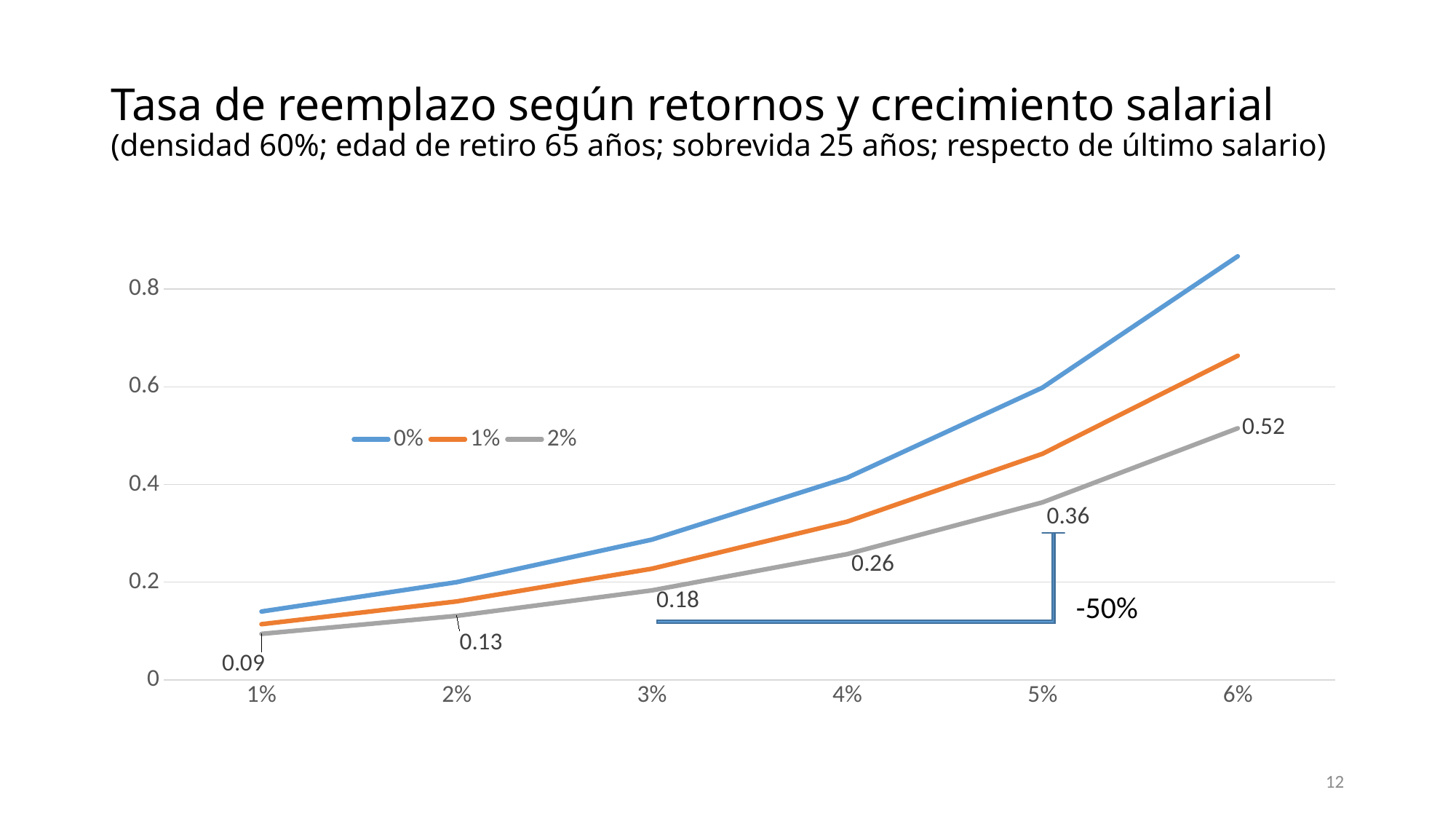
What kind of chart is shown on the slide? line chart At which x-axis value does the 2% series have its lowest value? 1% How many series does the legend list? 3 What is the value of the 2% series at 1% on the x axis? 0.09 At which x-axis value does the 2% series reach its highest value? 6% What is the value of the 2% series at 4% on the x axis? 0.26 Is the value of the 0% series at 6% greater or less than 0.8? greater Is the value of the 1% series at 4% greater or less than 0.4? less What is the difference between the 2% series values at 6% and at 1%? 0.43 At 6% on the x axis, which series has the higher value, 0% or 2%? 0% What is the difference between the 2% series values at 5% and at 3%? 0.18 What is the value of the 2% series at 6% on the x axis? 0.52